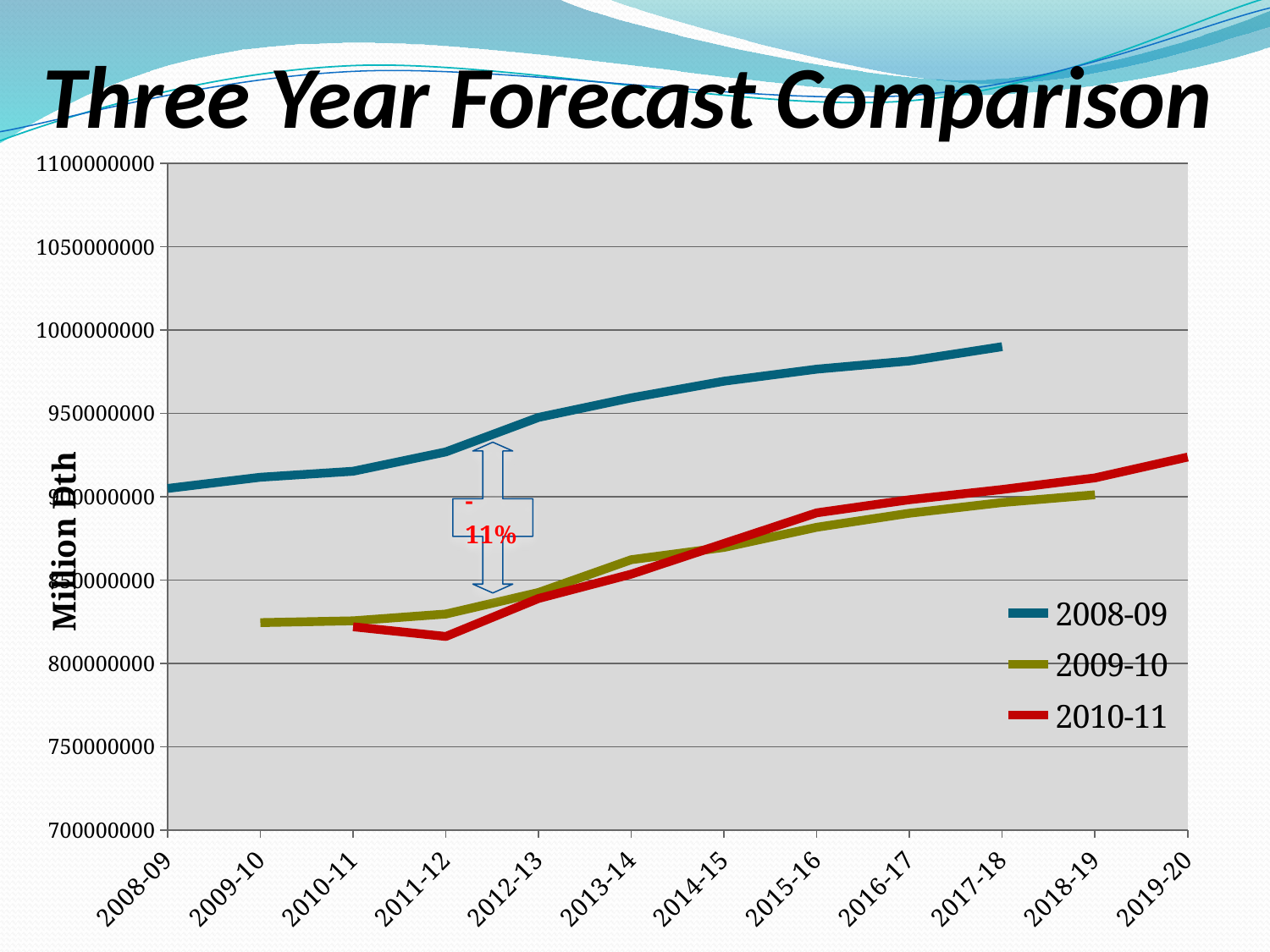
What kind of chart is shown on the slide? Line chart How many series does the legend list? 3 How many fiscal-year categories are shown along the x axis? 12 Is the value of the 2008-09 series at 2017-18 greater or less than 1000000000? less Does the 2008-09 series rise or fall from 2008-09 to 2017-18? Rises Is the value of the 2010-11 series at 2019-20 greater or less than 900000000? greater At 2011-12, which series has the larger value, 2009-10 or 2010-11? 2009-10 At 2011-12, which series has the larger value, 2008-09 or 2009-10? 2008-09 Is the value of the 2010-11 series at 2011-12 greater or less than 800000000? greater What is the title of the chart? Three Year Forecast Comparison Which series lies highest on the chart across the years it covers? 2008-09 What percentage is shown in the red annotation between the 2008-09 and 2009-10 lines? -11%